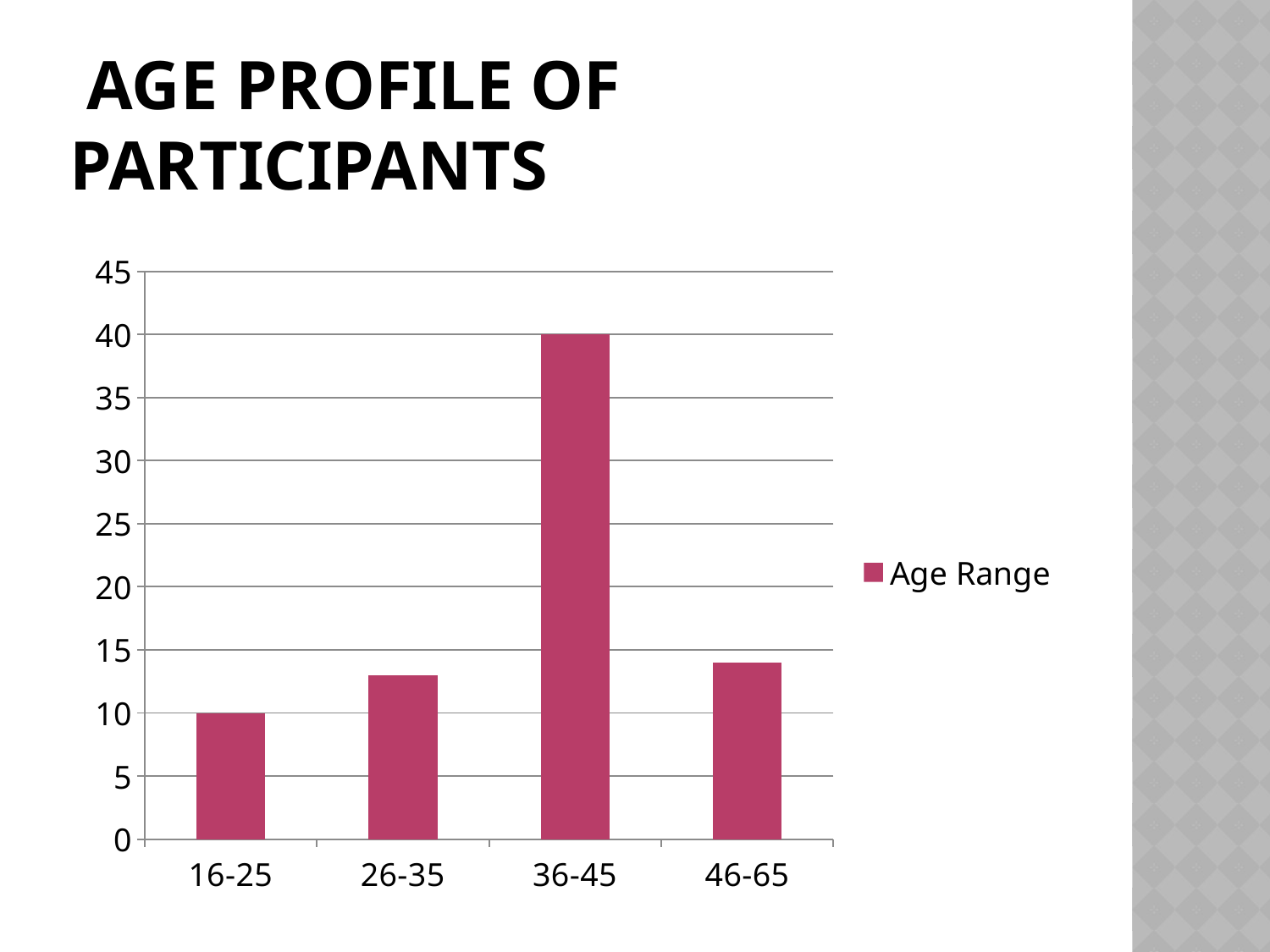
How many age range categories are shown on the x axis? 4 Which age range has the lowest value? 16-25 How many series does the legend list? 1 Is the value for 26-35 greater or less than 15? less Which age range has the highest value? 36-45 What is the value for the 16-25 age range? 10 What is the difference between the values for 36-45 and 16-25? 30 What is the series name shown in the legend? Age Range What kind of chart is shown on the slide? bar chart Is the value for 46-65 greater or less than 10? greater Which is larger, the value for 36-45 or the value for 46-65? 36-45 What is the value for the 36-45 age range? 40